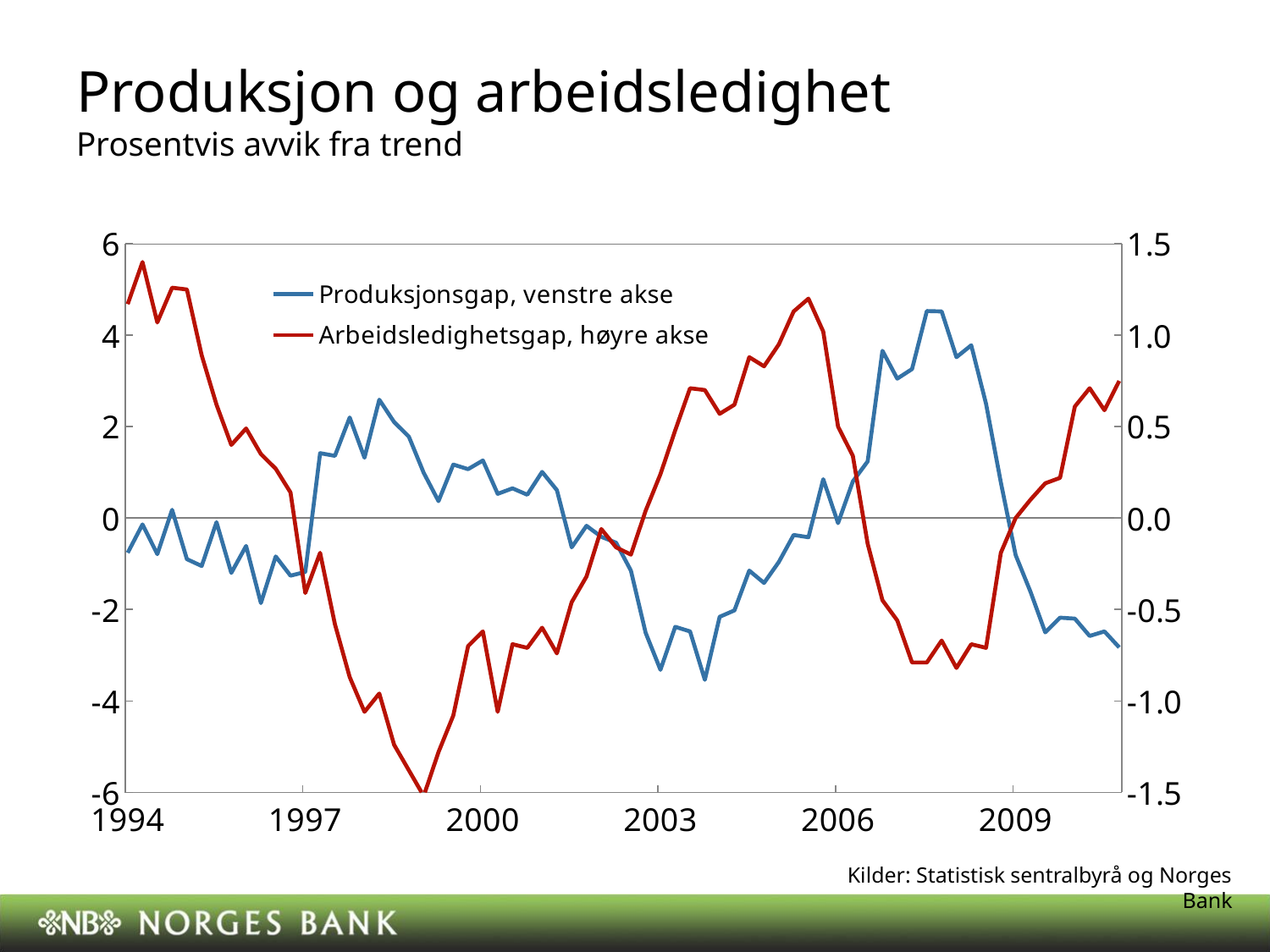
Is the lowest value of Arbeidsledighetsgap, reached between 1997 and 2000, greater or less than -1.0 on the right axis? less Does the Produksjonsgap series rise or fall between 2006 and its peak before 2009? Rise Is the value of Arbeidsledighetsgap at the start of 1994 greater or less than 1.0 on the right axis? greater How many year labels are shown on the x axis? 6 Does the Arbeidsledighetsgap series rise or fall between 1994 and 1997? Fall How many series does the legend list? 2 Is the highest value of Produksjonsgap, reached between 2006 and 2009, greater or less than 2 on the left axis? greater What kind of chart is shown on the slide? Line chart Which colour is used for the Produksjonsgap series? Blue What is the title of the chart on the slide? Produksjon og arbeidsledighet Does the Arbeidsledighetsgap series rise or fall between 2003 and 2006? Rise